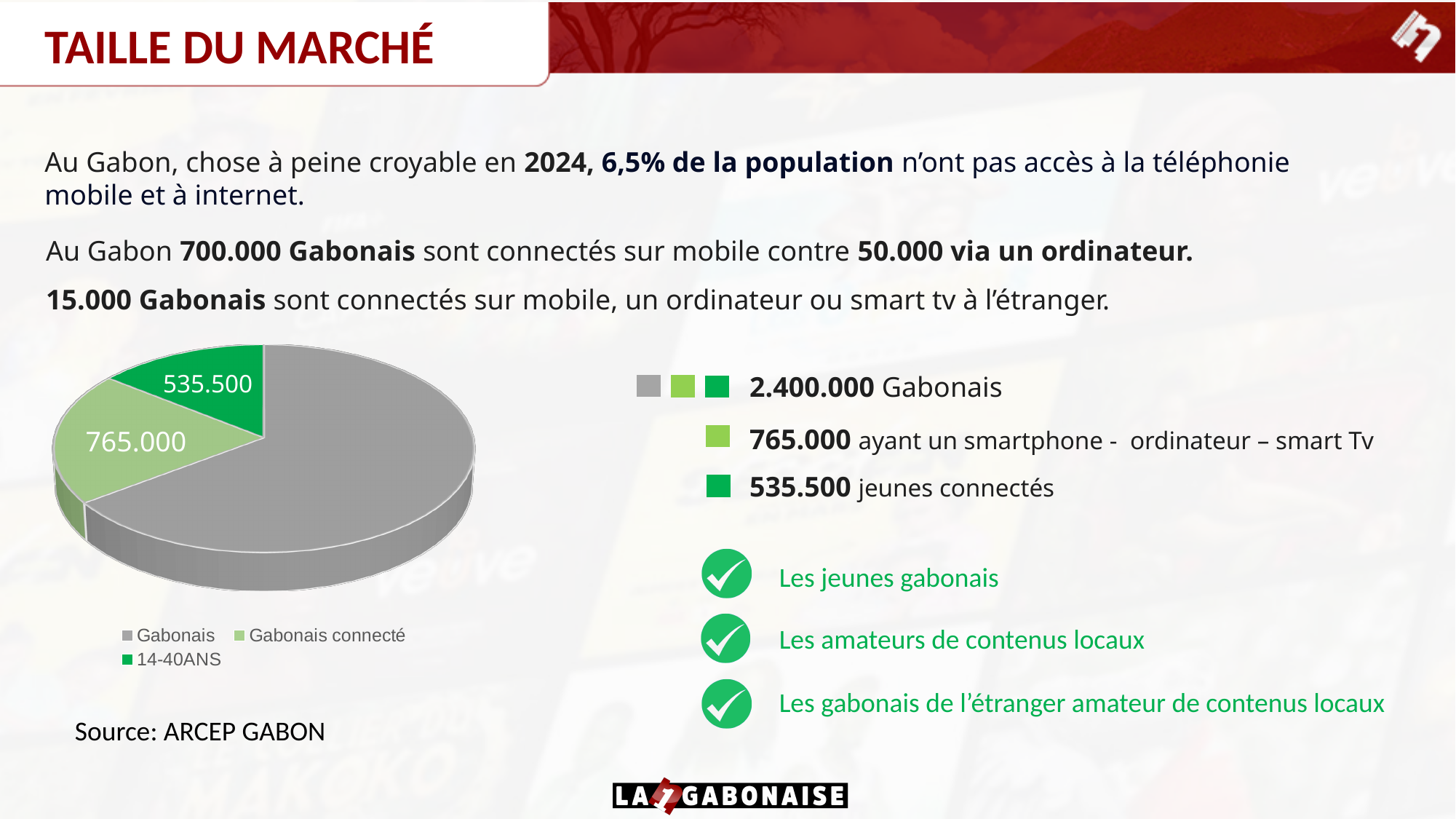
What colour is the Gabonais slice of the pie chart? grey What kind of chart is shown on the slide? pie chart How many slices does the pie chart have? 3 What are the three legend entries of the pie chart? Gabonais, Gabonais connecté, 14-40ANS What value is shown for the Gabonais connecté slice of the pie chart? 765.000 Which slice of the pie chart is the largest? Gabonais Which is larger in the pie chart, Gabonais connecté or 14-40ANS? Gabonais connecté Which slice of the pie chart is the smallest? 14-40ANS What is the difference between the Gabonais connecté value and the 14-40ANS value in the pie chart? 229.500 What value is shown for the 14-40ANS slice of the pie chart? 535.500